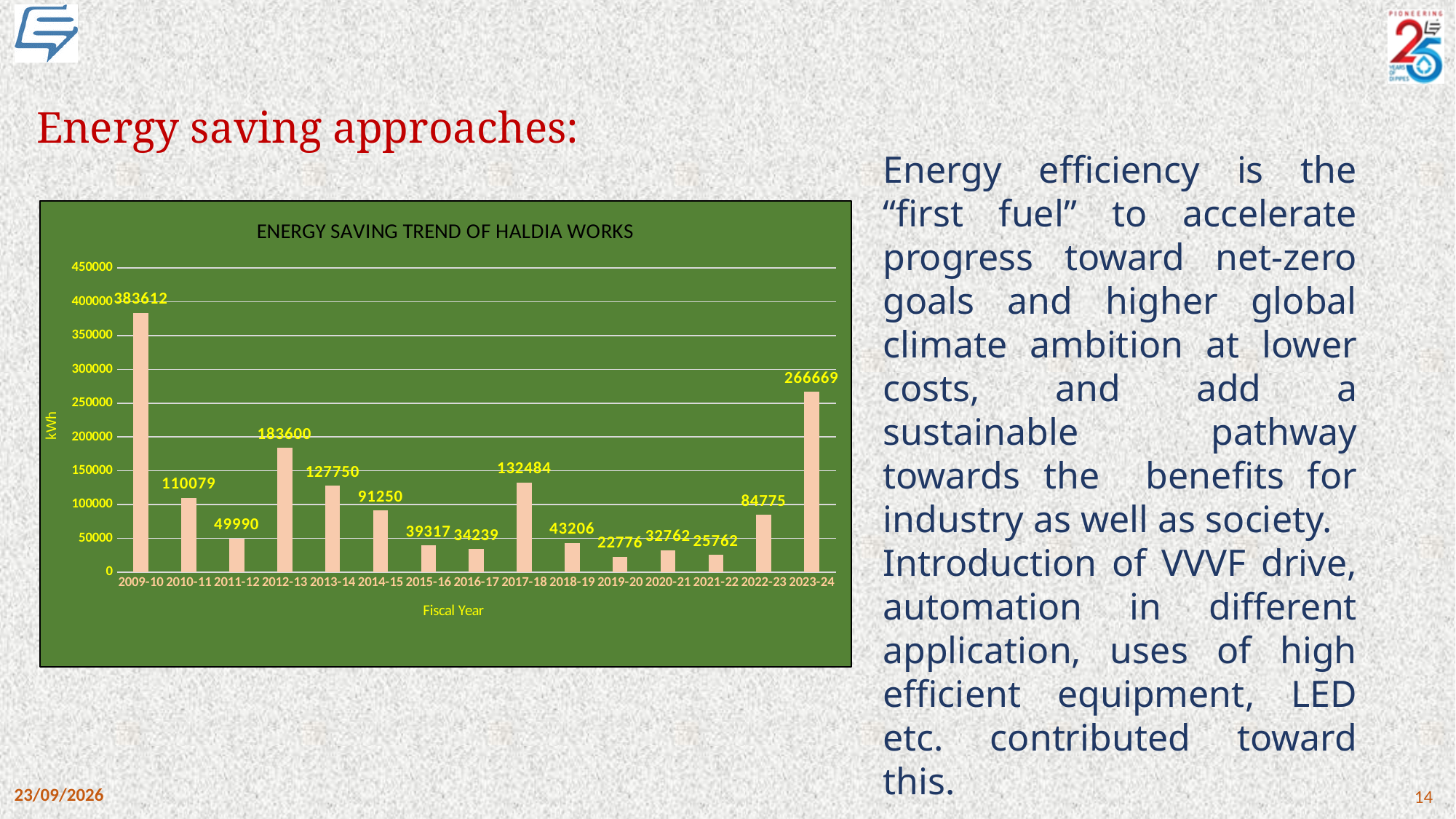
Which fiscal year has the lowest energy saving? 2019-20 What is the energy saving value for 2017-18? 132484 What is the title of the chart? ENERGY SAVING TREND OF HALDIA WORKS What kind of chart is shown on the slide? bar chart What is the energy saving value for 2009-10? 383612 How many fiscal years are shown on the x axis? 15 Which fiscal year has the highest energy saving? 2009-10 What is the energy saving value for 2023-24? 266669 Which fiscal year has a larger energy saving, 2010-11 or 2014-15? 2010-11 What is the difference between the energy saving in 2012-13 and 2013-14? 55850 Is the value for 2022-23 greater or less than 100000? less What unit is shown on the y axis of the chart? kWh